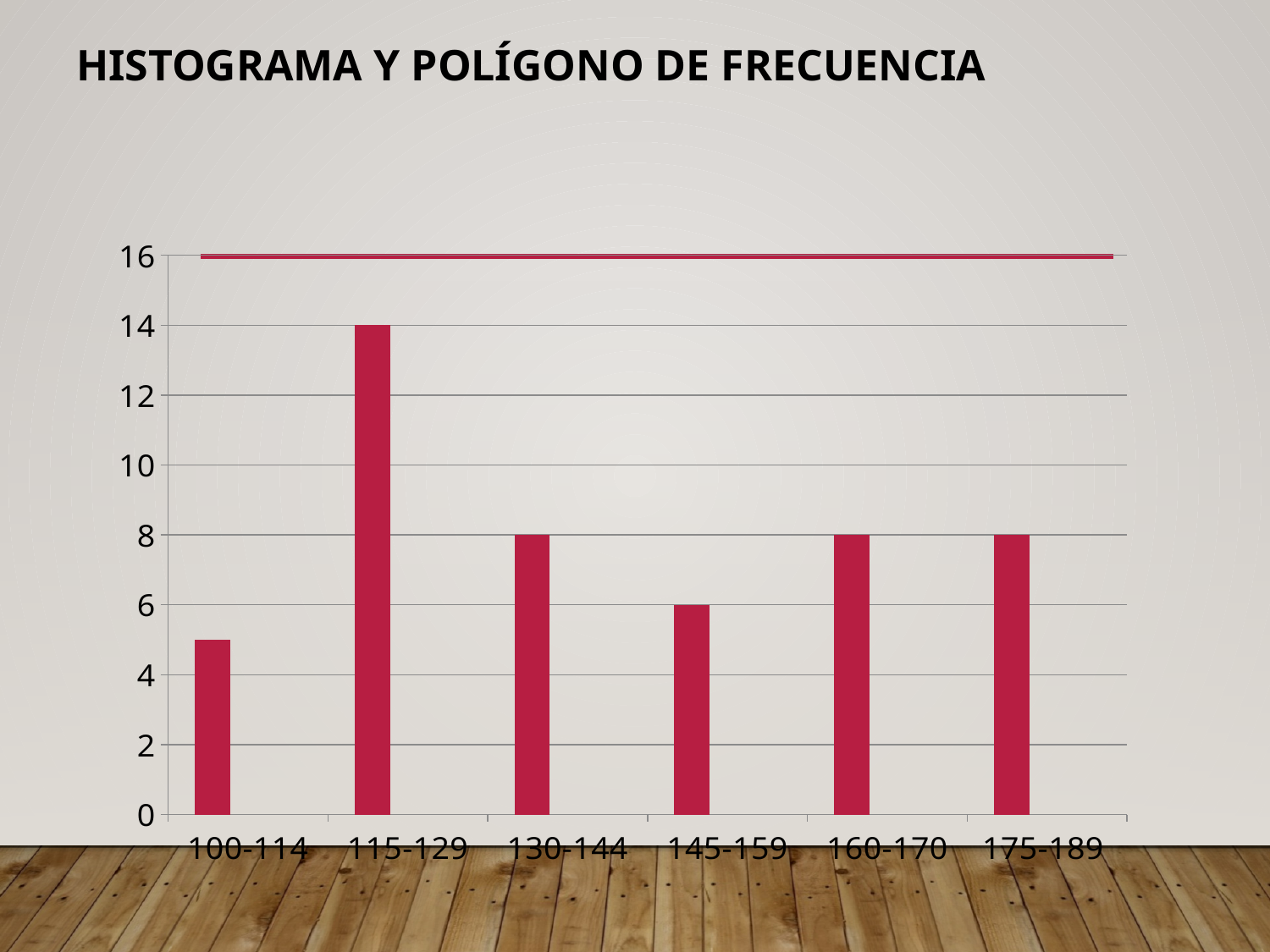
What is the value for the 115-129 category? 14 What kind of chart is shown on the slide? bar chart Which category has the highest bar? 115-129 Is the value for 100-114 greater or less than 6? less What is the title of the slide? HISTOGRAMA Y POLÍGONO DE FRECUENCIA Which category has the lowest bar? 100-114 What is the value for the 160-170 category? 8 What is the value for the 130-144 category? 8 Which is larger, the value for 130-144 or the value for 145-159? 130-144 What is the value for the 145-159 category? 6 What is the difference between the values for 115-129 and 145-159? 8 How many categories are shown on the x axis of the chart? 6